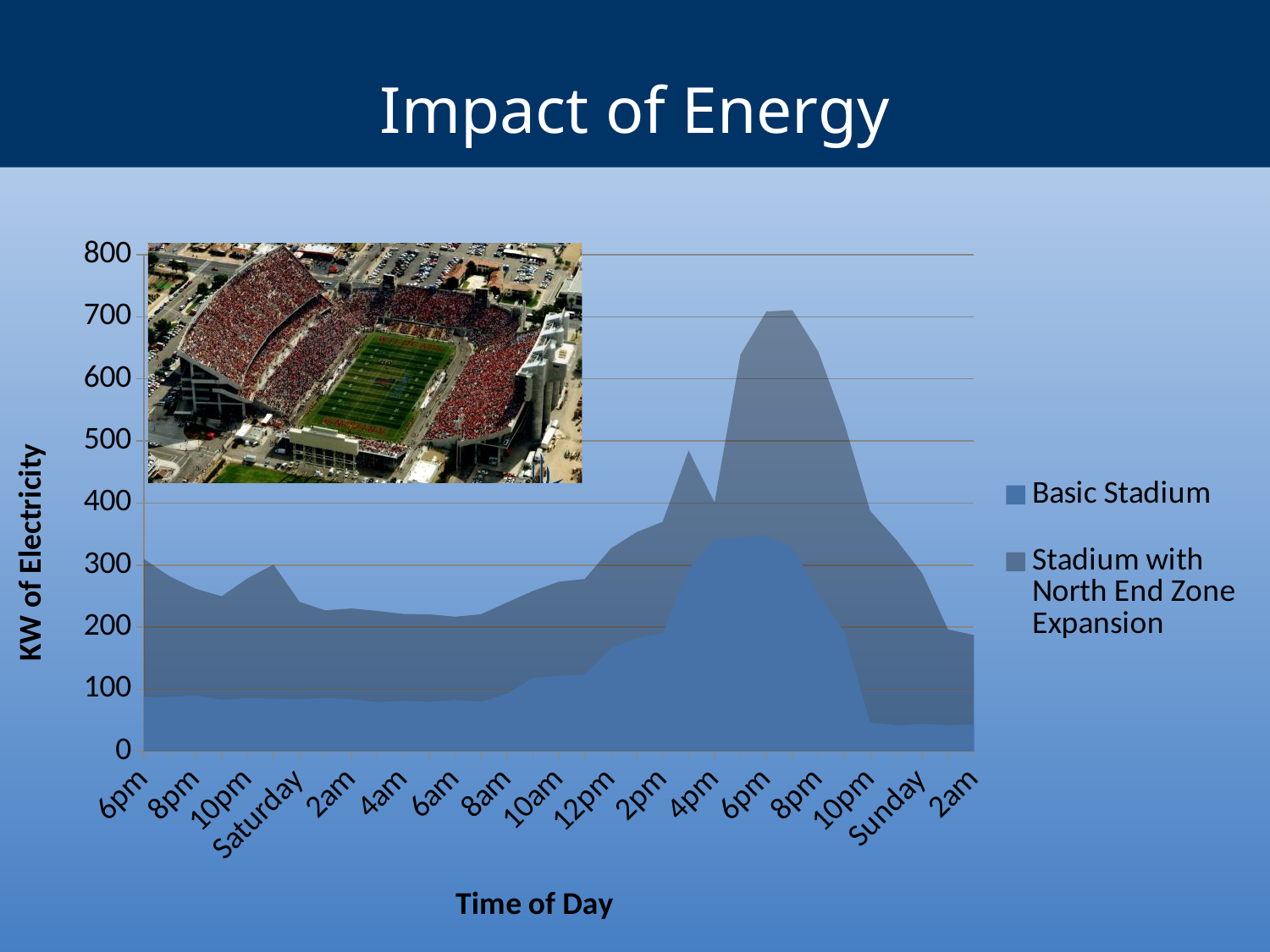
Is the Stadium with North End Zone Expansion value at the final 2am point greater or less than 300? less What kind of chart is shown on the slide? Area chart What are the two series named in the legend? Basic Stadium; Stadium with North End Zone Expansion Is the Basic Stadium value at the first 6pm point greater or less than 100? less Is the peak value of the Stadium with North End Zone Expansion series greater or less than 600? greater How many time labels are shown along the x axis? 17 Between 6pm and 10pm on Saturday, does the Stadium with North End Zone Expansion series rise or fall? Fall What is the title of the vertical axis? KW of Electricity Which series reaches the higher peak, Basic Stadium or Stadium with North End Zone Expansion? Stadium with North End Zone Expansion How many series does the legend list? 2